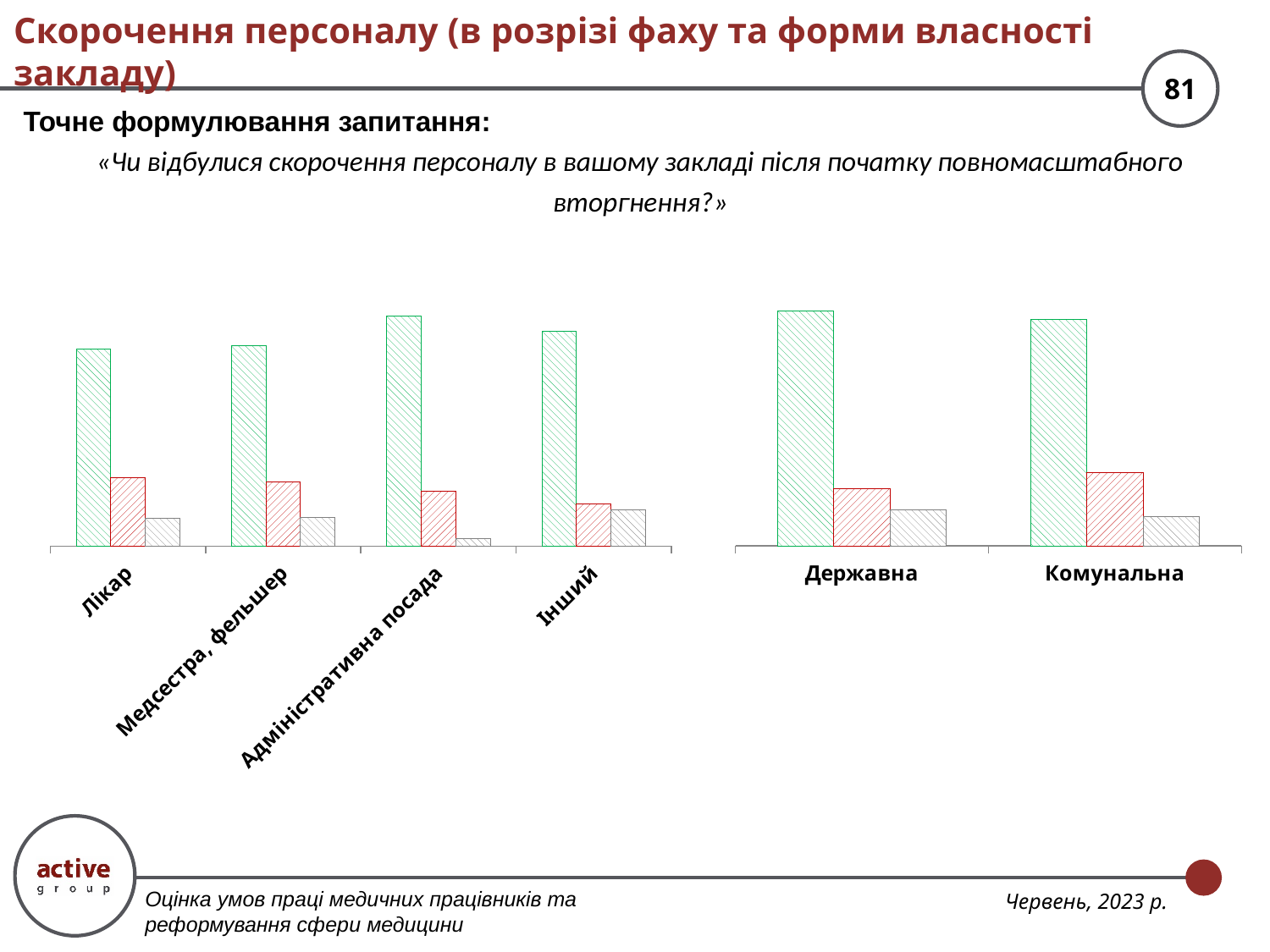
What kind of chart is the left chart on the slide? bar chart In the left chart, how many bars are shown for each category? 3 What are the two categories on the x axis of the right chart? Державна, Комунальна In the left chart, which category has the tallest green bar? Адміністративна посада In the left chart, which category has the shortest grey bar? Адміністративна посада In the left chart, for Інший, which bar is taller: the red bar or the grey bar? red How many categories are shown on the x axis of the left chart? 4 In the left chart, for Лікар, which bar is taller: the green bar or the red bar? green How many categories are shown on the x axis of the right chart? 2 In the right chart, for Державна, which bar is taller: the red bar or the grey bar? red What kind of chart is the right chart on the slide? bar chart